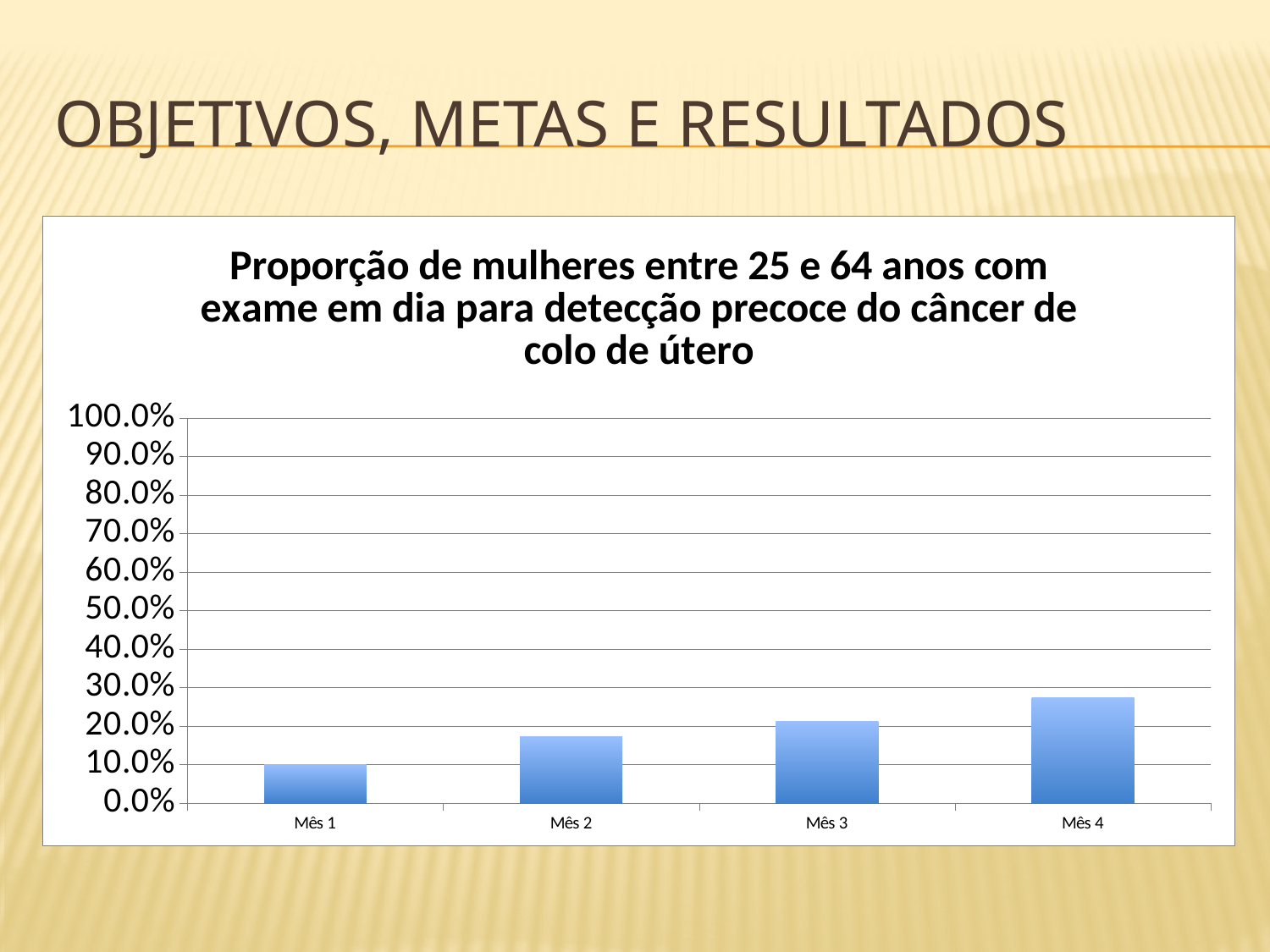
Do the values rise or fall from Mês 1 to Mês 4? rise Is the value for Mês 1 greater or less than 20.0%? less What is the title of the chart? Proporção de mulheres entre 25 e 64 anos com exame em dia para detecção precoce do câncer de colo de útero Is the value for Mês 4 greater or less than 30.0%? less What kind of chart is shown on the slide? bar chart Which month has the lowest value on the chart? Mês 1 Which month has the highest value on the chart? Mês 4 Is the value for Mês 2 greater or less than 20.0%? less Which is larger, the value for Mês 2 or the value for Mês 4? Mês 4 How many categories (months) are plotted on the chart? 4